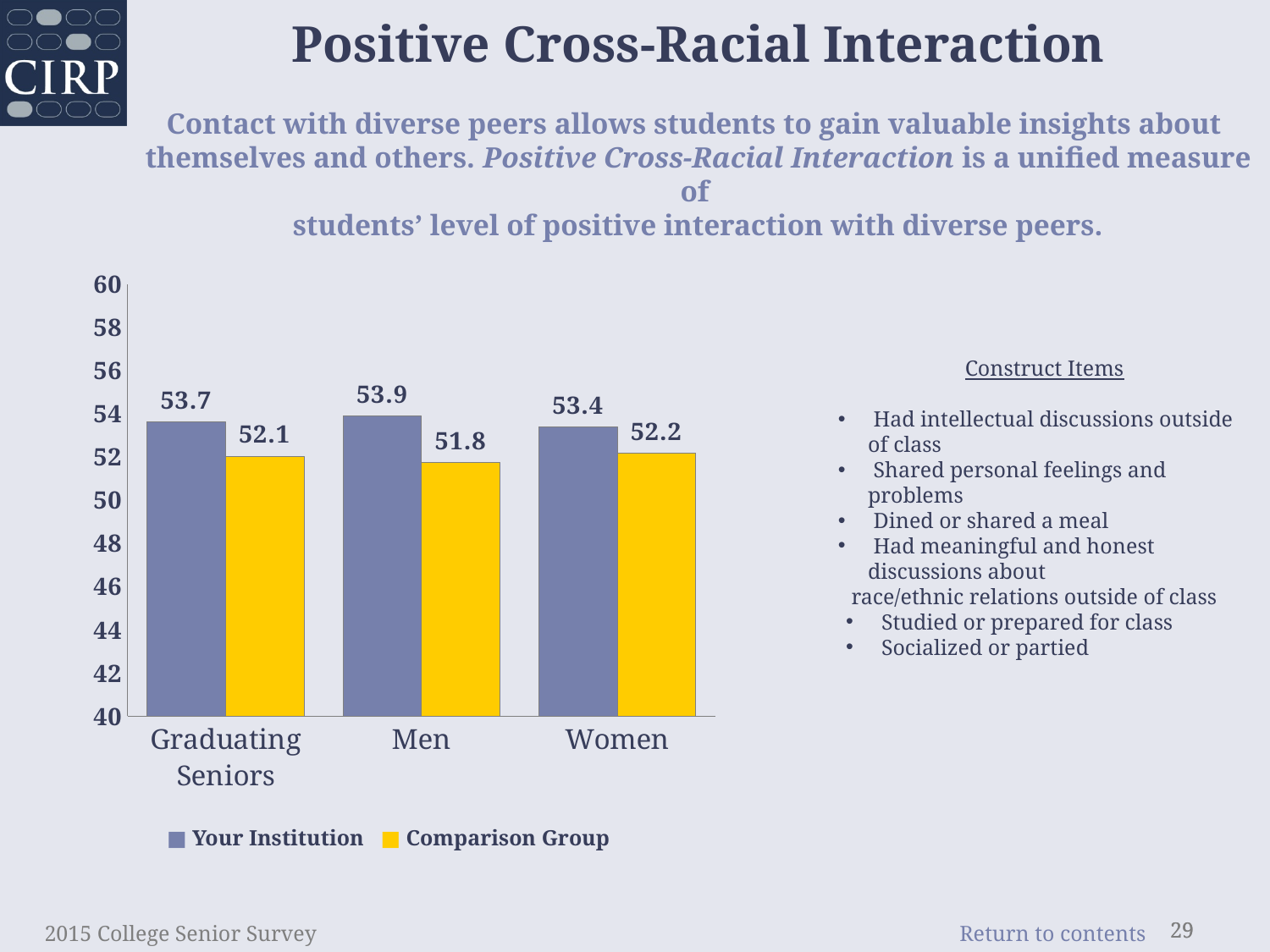
Which category has the lowest value for the Comparison Group? Men What is the value for the Comparison Group for Women? 52.2 What is the difference between Your Institution and the Comparison Group for Men? 2.1 Which category has the highest value for Your Institution? Men What is the difference between Your Institution and the Comparison Group for Graduating Seniors? 1.6 Is the value for Your Institution for Women greater or less than 52? greater What kind of chart is shown on the slide? Bar chart For Women, which is larger: Your Institution or the Comparison Group? Your Institution How many series does the legend list? 2 What is the value for Your Institution for Graduating Seniors? 53.7 How many categories are shown on the x axis? 3 What is the value for the Comparison Group for Men? 51.8